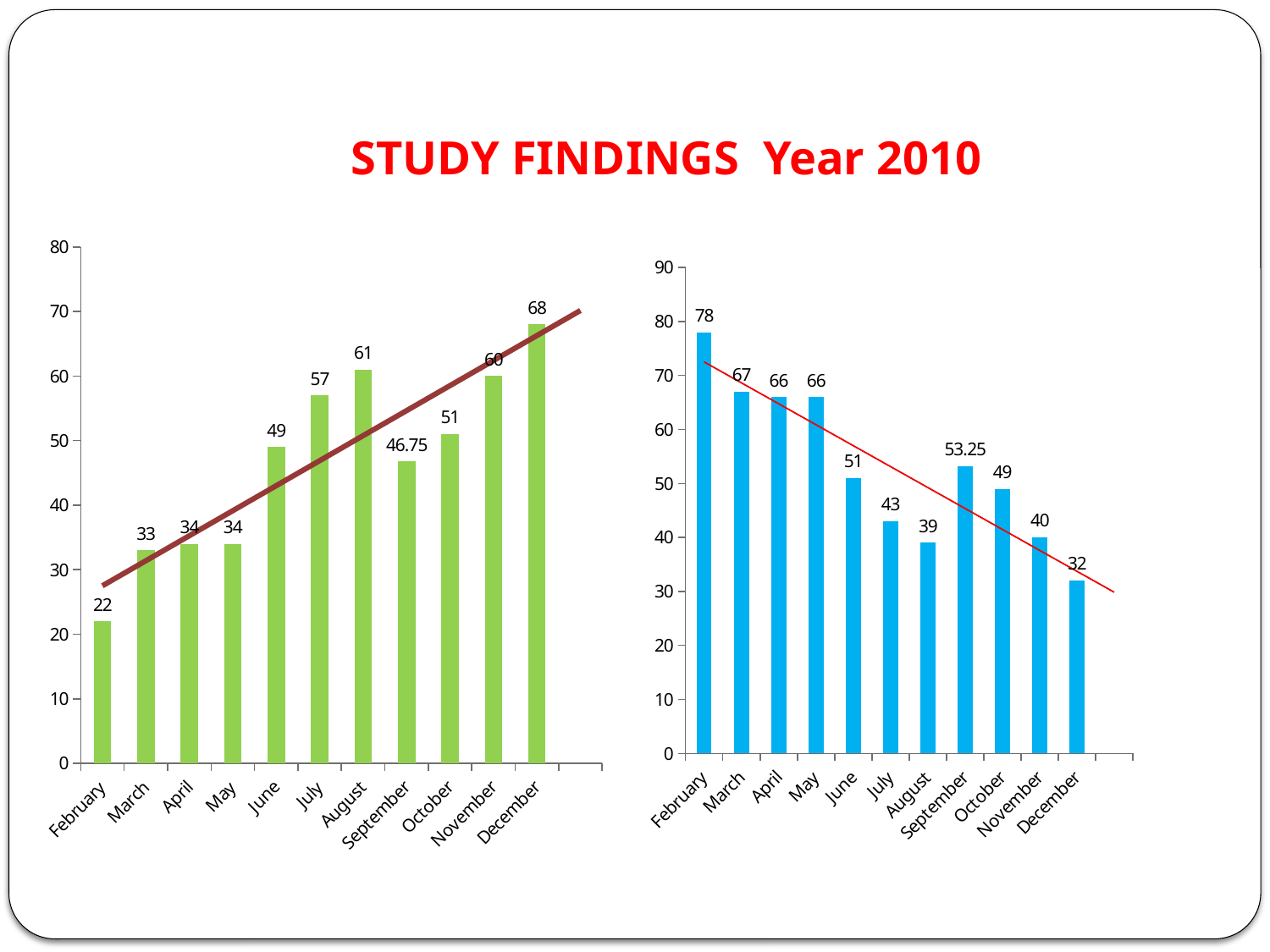
In the right (blue) chart, which month has the lowest value? December In the left (green) chart, which is larger, the value for August or the value for November? August In the right (blue) chart, do the values generally rise or fall from February to December? fall In the right (blue) chart, which month has the highest value? February How many months are plotted in the left (green) chart? 11 In the right (blue) chart, what is the value for September? 53.25 In the right (blue) chart, what is the difference between the values for February and December? 46 In the left (green) chart, what is the difference between the values for December and February? 46 In the left (green) chart, which month has the highest value? December In the right (blue) chart, which is larger, the value for July or the value for October? October What kind of chart is the right (blue) chart? bar chart In the left (green) chart, what is the value for September? 46.75